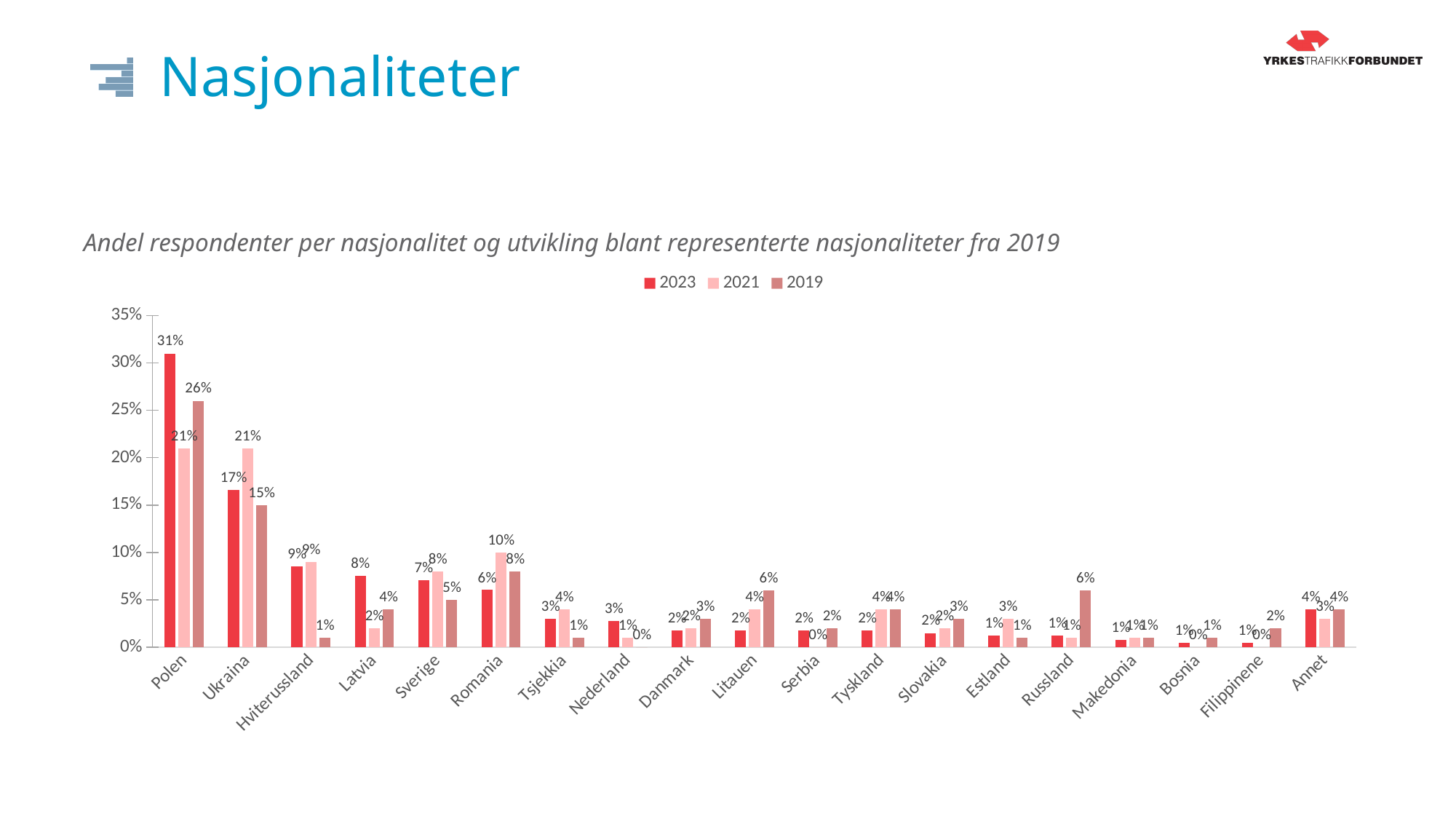
What is the difference between the 2019 and 2023 values for Litauen? 4% What is the 2019 value for Russland? 6% What is the 2021 value for Romania? 10% Which nationality has the highest 2023 value? Polen What is the 2023 value for Polen? 31% What kind of chart is shown on the slide? bar chart Which series are listed in the legend? 2023, 2021, 2019 How many series does the legend list? 3 Which is larger for Ukraina: the 2023 value or the 2021 value? 2021 How many nationality categories are shown on the x axis? 19 What is the difference between the 2023 and 2021 values for Polen? 10% Is the 2019 value for Polen greater or less than 25%? greater